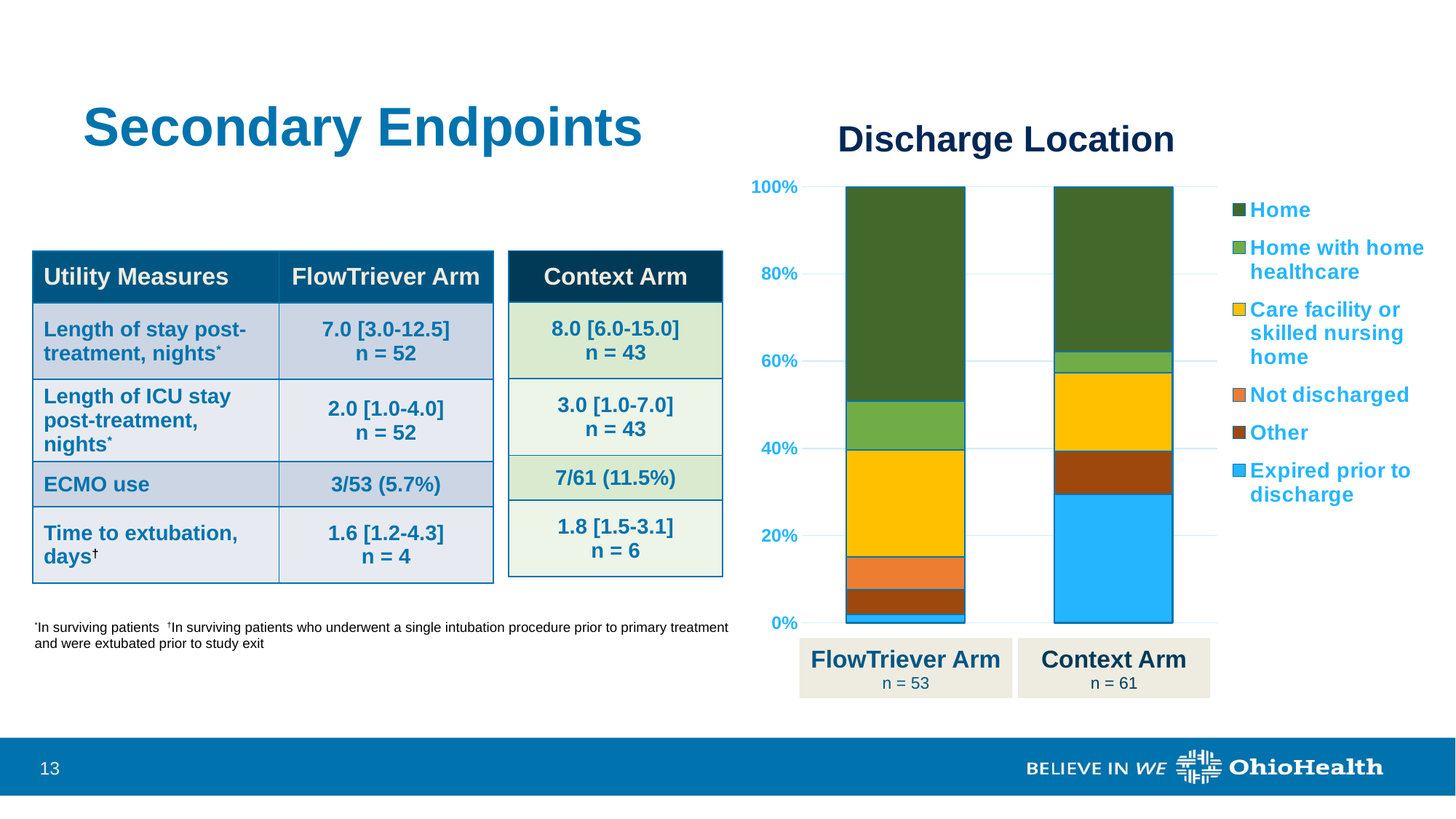
In the Discharge Location chart, what is the sample size (n) shown for the Context Arm? n = 61 What is the title of the chart on the slide? Discharge Location In the Discharge Location chart, is the Home share for the Context Arm greater or less than 60%? less In the Discharge Location chart, which arm has the larger Expired prior to discharge share? Context Arm In the Discharge Location chart, is the Expired prior to discharge share for the Context Arm greater or less than 20%? greater How many bars (arms) are shown in the Discharge Location chart? 2 What type of chart is the Discharge Location chart? Stacked bar chart In the Discharge Location chart, which arm has the larger Home with home healthcare share? FlowTriever Arm In the Discharge Location chart, is the Expired prior to discharge share for the FlowTriever Arm greater or less than 20%? less In the Discharge Location chart, which arm has the larger Home share? FlowTriever Arm How many discharge location categories does the legend of the Discharge Location chart list? 6